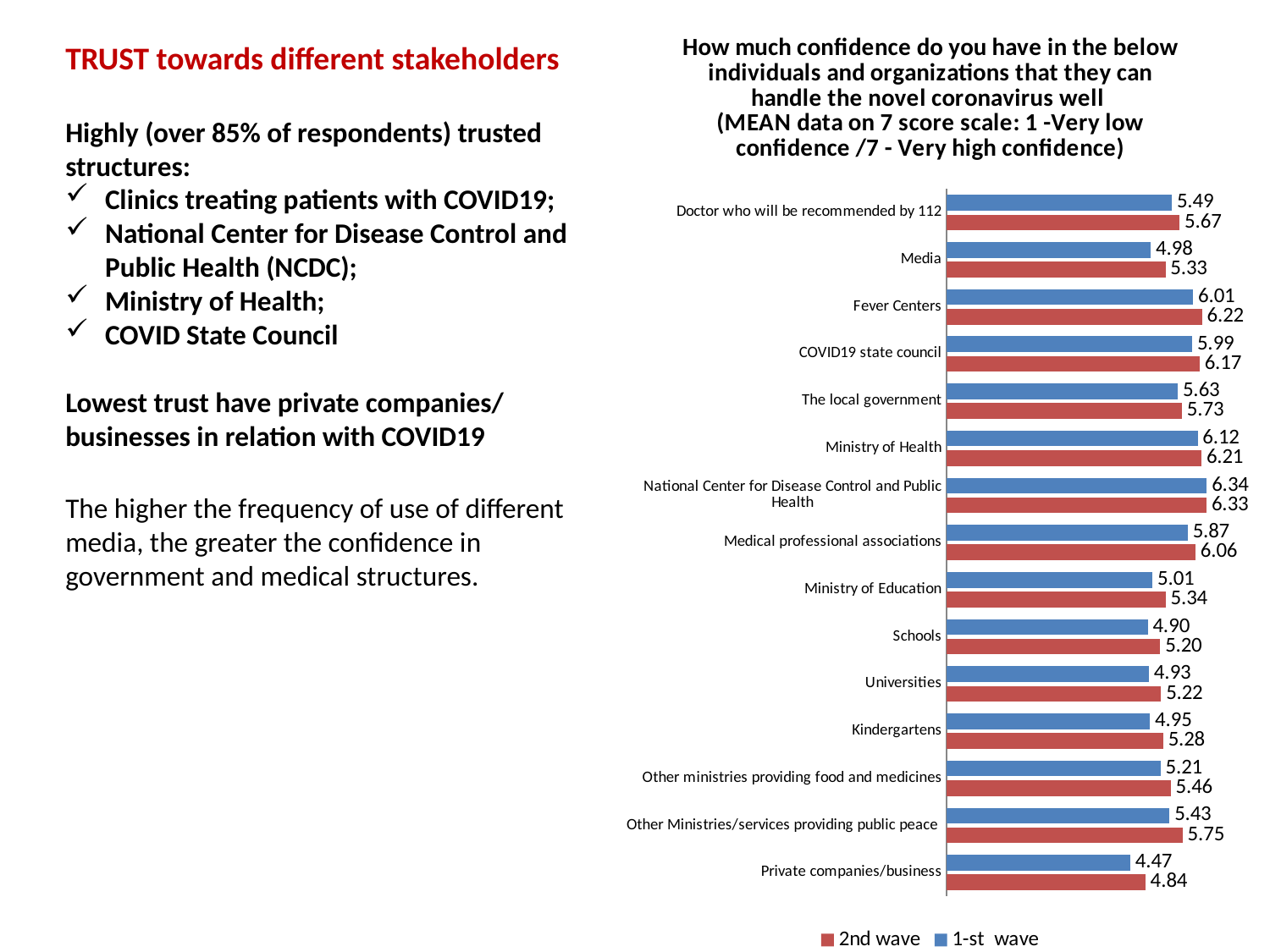
What is the 2nd wave value for Ministry of Health? 6.21 Which category has the lowest 2nd wave value? Private companies/business What is the 2nd wave value for Private companies/business? 4.84 What is the difference between the 2nd wave and 1-st wave values for Private companies/business? 0.37 Which category has the highest 1-st wave value? National Center for Disease Control and Public Health Which is larger for Schools: the 1-st wave value or the 2nd wave value? 2nd wave What type of chart is shown on the slide? bar chart How many individuals/organizations (categories) are shown in the chart? 15 Which colour represents the 2nd wave series in the chart? red How many series does the chart legend list? 2 Which has a higher 1-st wave value: Fever Centers or The local government? Fever Centers What is the 1-st wave value for Media? 4.98